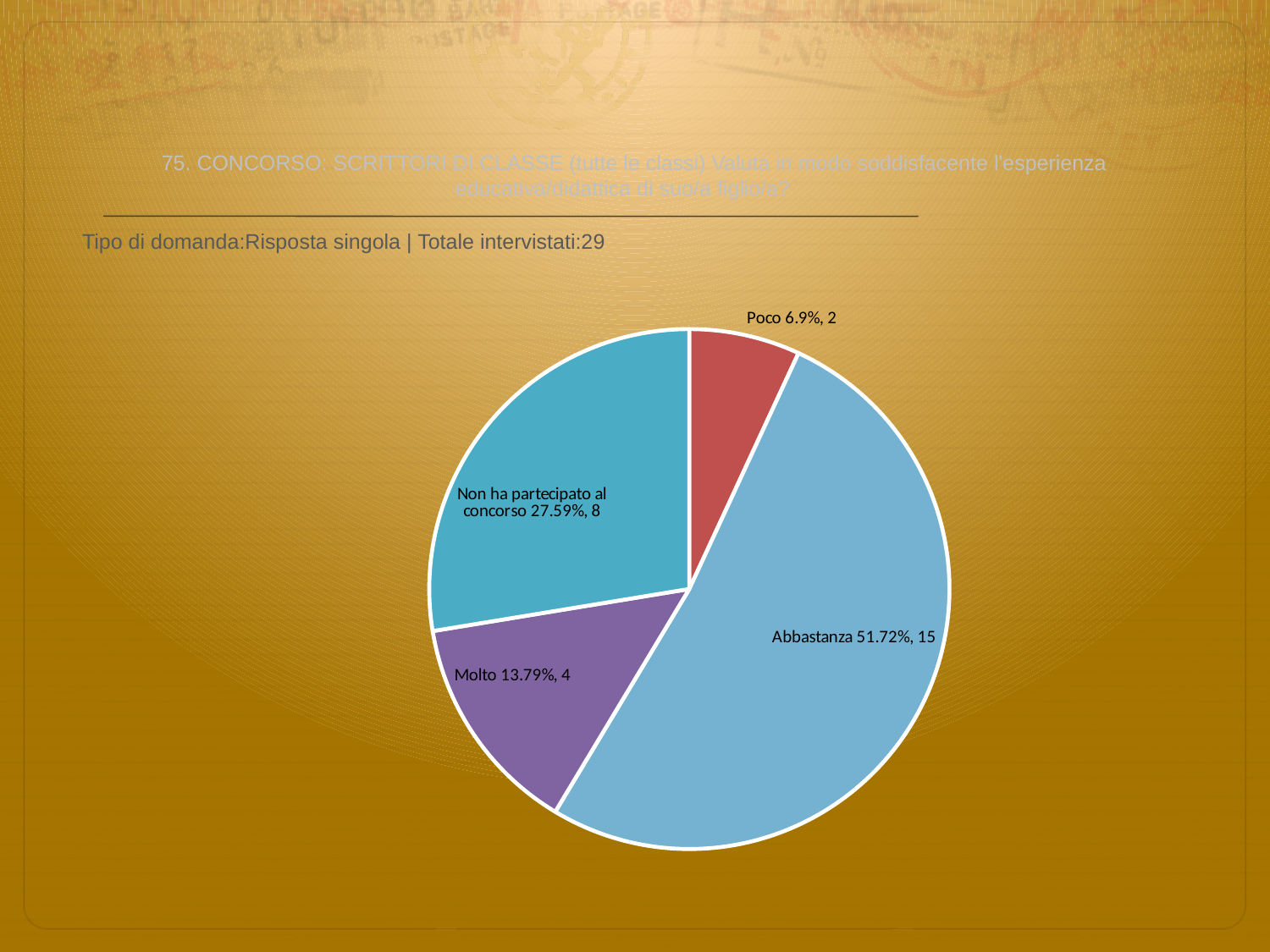
Which has more respondents, 'Molto' or 'Poco'? Molto What kind of chart is shown on the slide? pie chart How many respondents chose 'Molto'? 4 Which category has the largest slice? Abbastanza What colour is the 'Molto' slice? purple What is the total number of respondents (Totale intervistati) stated on the slide? 29 Which category has the smallest slice? Poco How many slices does the pie chart have? 4 What is the difference in respondent count between 'Abbastanza' and 'Non ha partecipato al concorso'? 7 What percentage share does the 'Poco' slice have? 6.9% What percentage share does the 'Abbastanza' slice have? 51.72% How many respondents chose 'Non ha partecipato al concorso'? 8